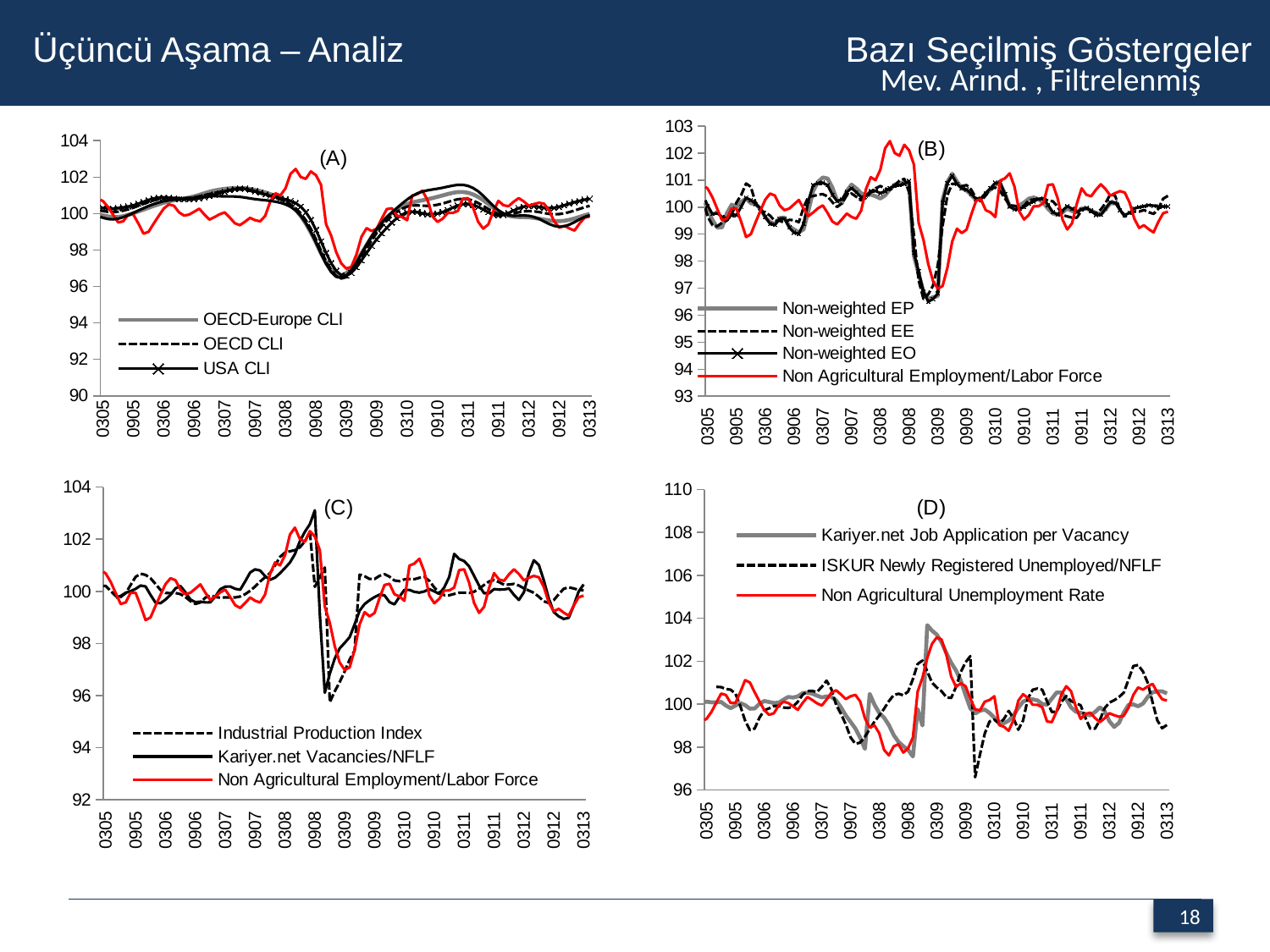
What kind of chart is chart (A)? line chart How many series does the legend of chart (B) list? 4 Which series in chart (B) is drawn with x markers? Non-weighted EO In chart (C), is the peak value of Kariyer.net Vacancies/NFLF around 0308 greater or less than 102? greater In chart (B), is the value of Non-weighted EP at 0309 greater or less than 98? less In chart (D), is the peak value of Kariyer.net Job Application per Vacancy around 0309 greater or less than 102? greater Which series in chart (D) is drawn in red? Non Agricultural Unemployment Rate How many series does the legend of chart (C) list? 3 How many series does the legend of chart (D) list? 3